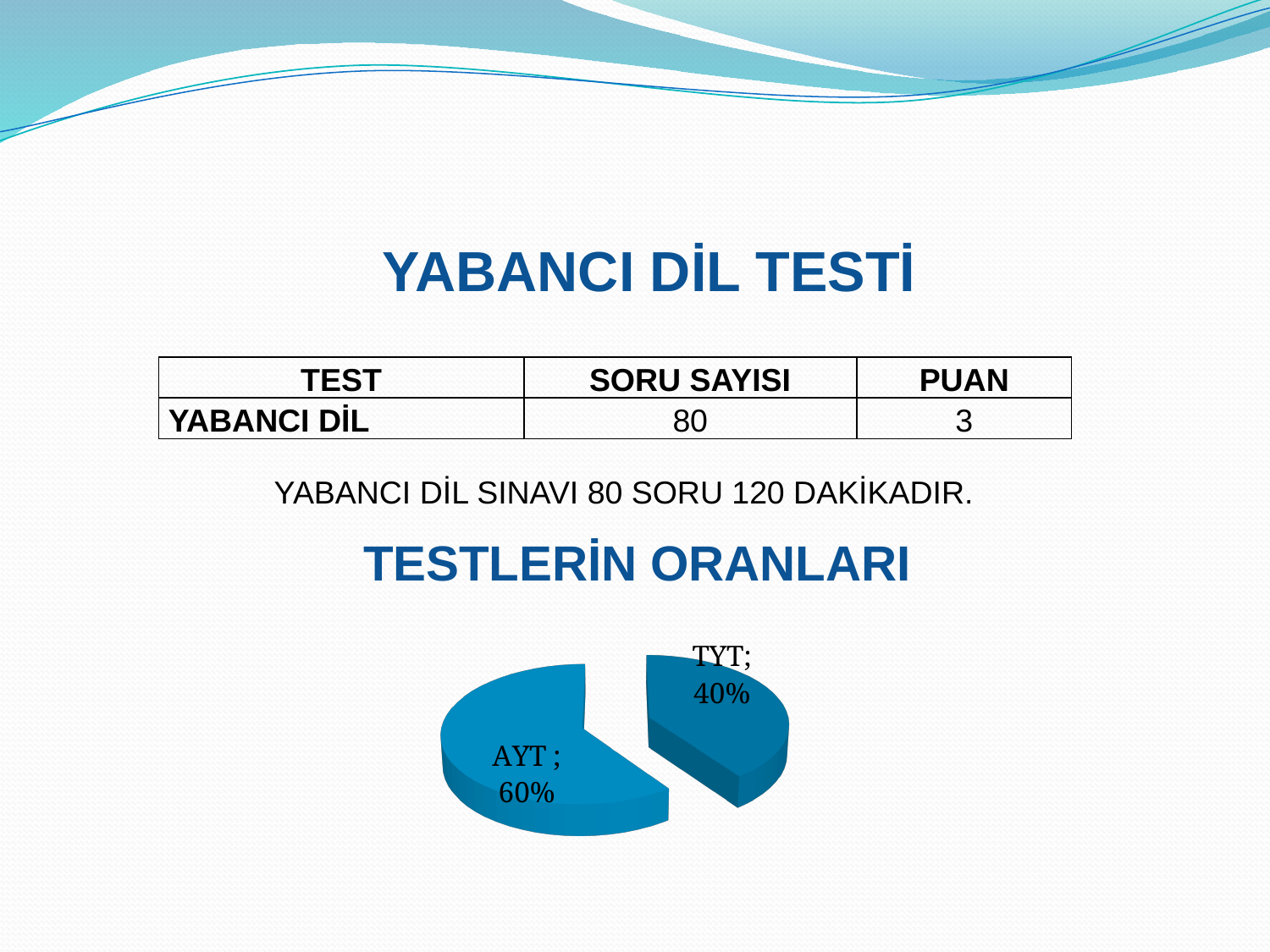
Which slice of the pie chart is the largest? AYT What heading appears directly above the pie chart? TESTLERİN ORANLARI What is the difference in percentage points between the AYT and TYT slices? 20% Is the pie chart drawn with a 3-D effect? yes What is the total of the two slices shown in the pie chart? 100% How many slices does the pie chart have? 2 Which is larger in the pie chart, AYT or TYT? AYT Which slice of the pie chart is the smallest? TYT What kind of chart is shown under the heading TESTLERİN ORANLARI? pie chart What share of the pie chart does AYT have? 60% What share of the pie chart does TYT have? 40%